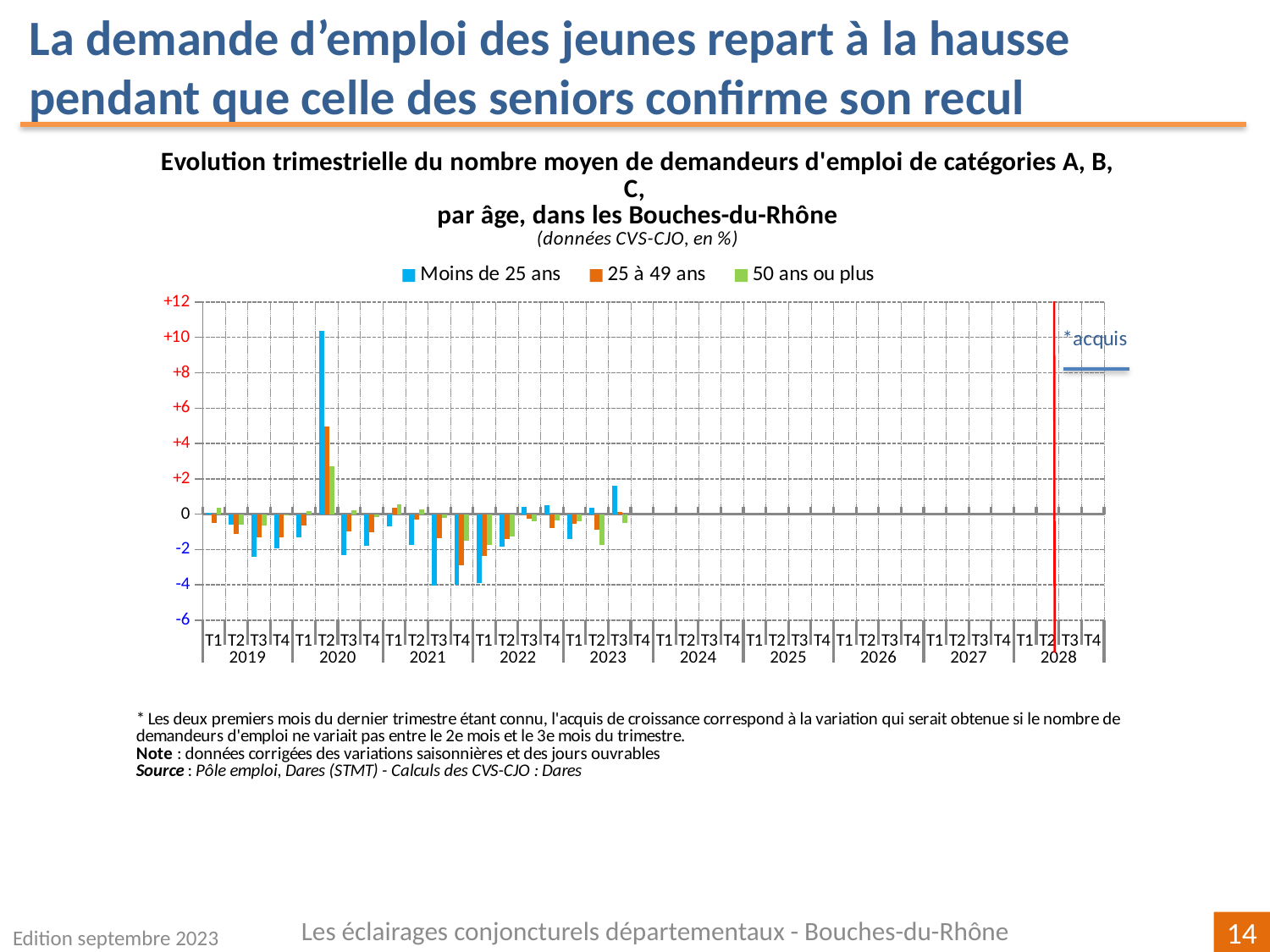
Is the value for '25 à 49 ans' in T2 2020 greater or less than +4? greater Is the value for '50 ans ou plus' in T2 2020 greater or less than +2? greater What is the highest value shown on the vertical axis? +12 In T2 2020, which series has the larger value: 'Moins de 25 ans' or '25 à 49 ans'? Moins de 25 ans Is the value for 'Moins de 25 ans' in T2 2020 greater or less than +8? greater What kind of chart is shown on the slide? bar chart What are the three series named in the legend? Moins de 25 ans, 25 à 49 ans, 50 ans ou plus In which quarter does the 'Moins de 25 ans' series reach its highest value? T2 2020 How many series does the legend list? 3 How many years are labelled along the x axis? 10